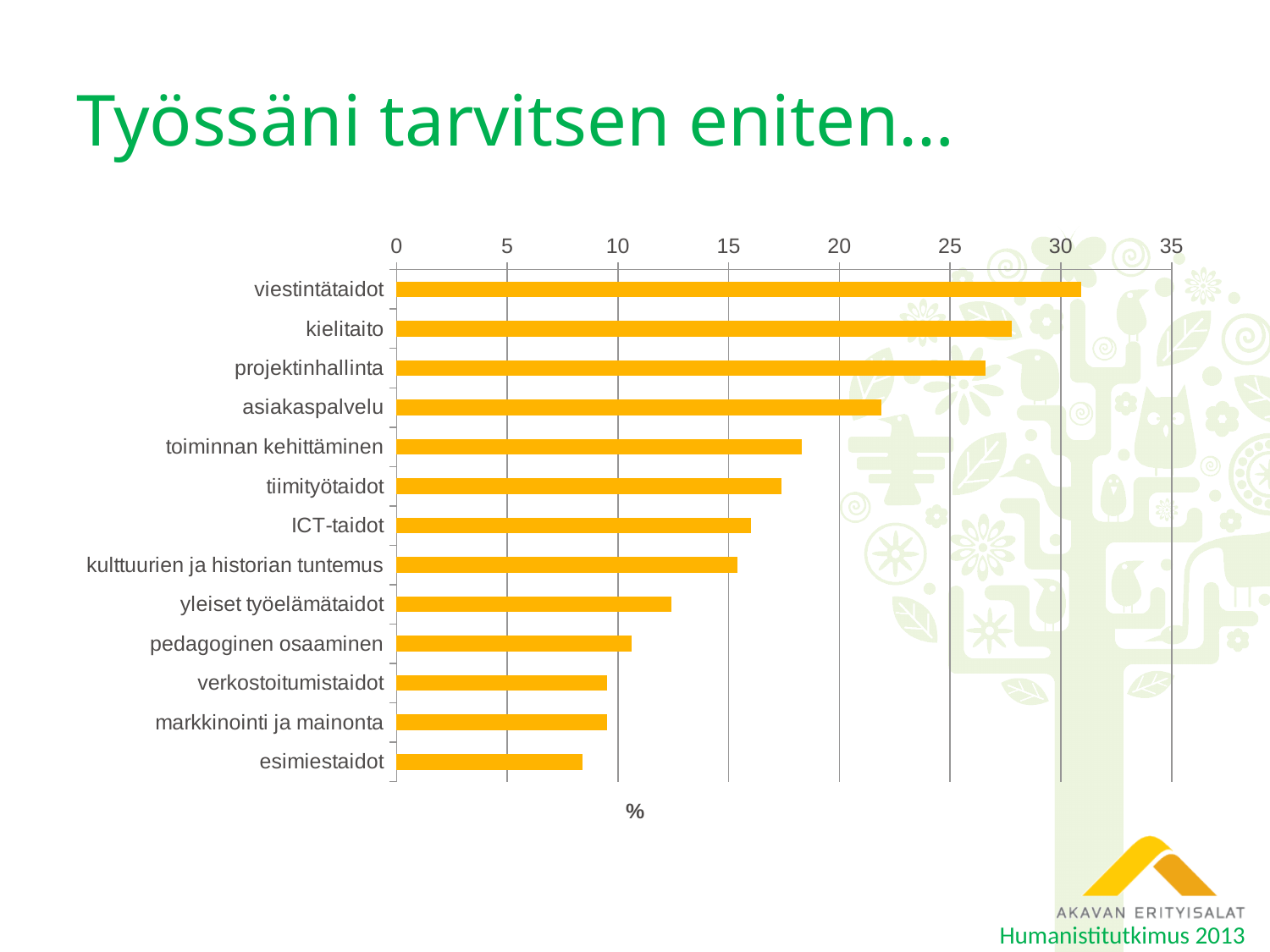
What kind of chart is shown on the slide? bar chart How many categories are plotted in the chart? 13 Which category has the highest value? viestintätaidot Which category has the lowest value? esimiestaidot Is the value for toiminnan kehittäminen greater or less than 15? greater Is the value for yleiset työelämätaidot greater or less than 15? less What is the label shown on the horizontal axis of the chart? % Is the value for asiakaspalvelu greater or less than 20? greater Do the bar values increase or decrease going from the top category to the bottom category? decrease Which has a larger value, kielitaito or asiakaspalvelu? kielitaito